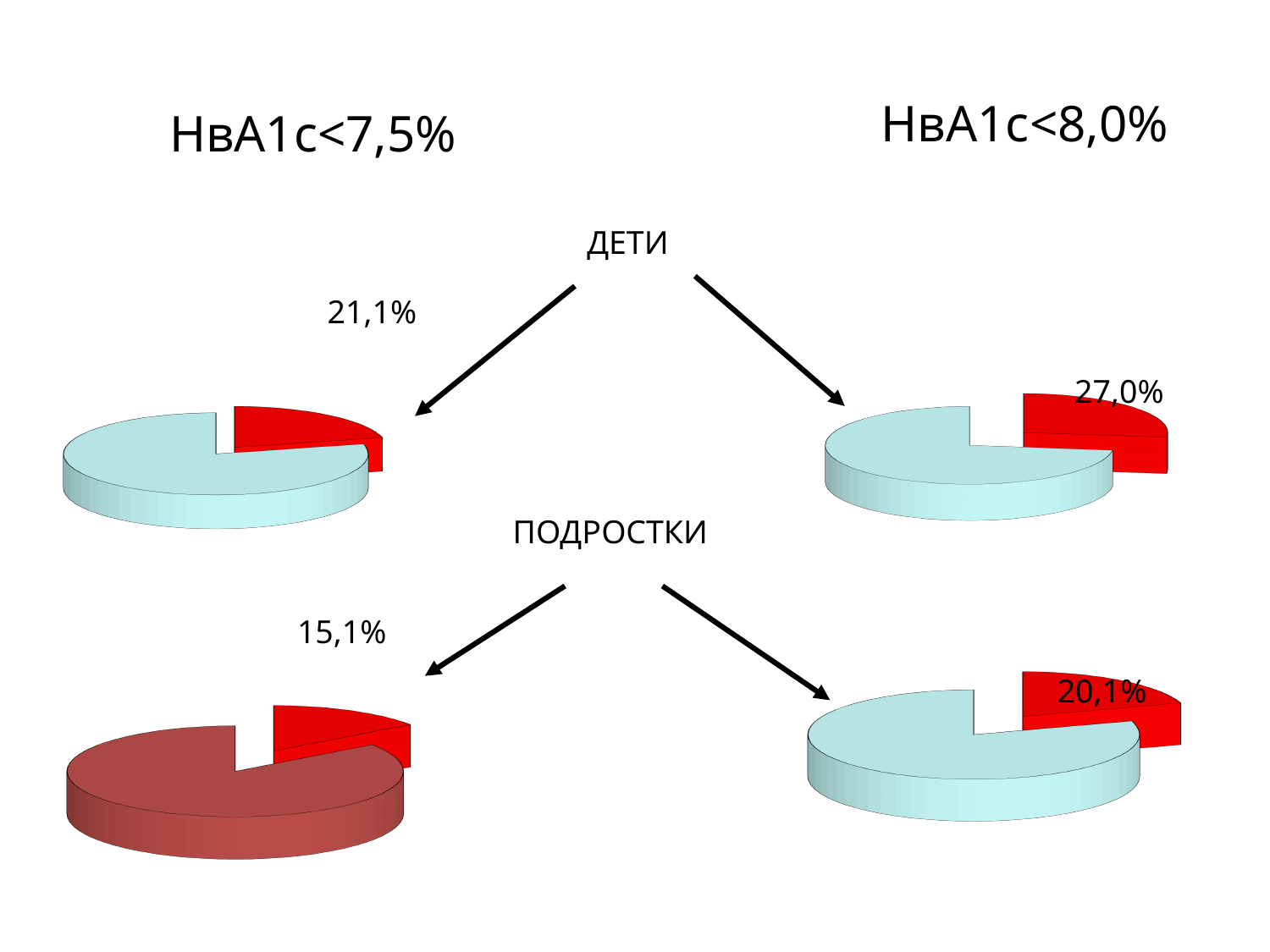
What type of chart is used on this slide? Pie chart What is the difference between the labelled percentages for ДЕТИ at HbA1c<8,0% and ДЕТИ at HbA1c<7,5%? 5,9% How many pie charts are shown on the slide? 4 In the top-right pie chart (ДЕТИ, HbA1c<8,0%), what percentage is shown for the red slice? 27,0% In the bottom-left pie chart (ПОДРОСТКИ, HbA1c<7,5%), what colour is the large non-exploded slice? Dark red What is the difference between the labelled percentages for ПОДРОСТКИ at HbA1c<8,0% and ПОДРОСТКИ at HbA1c<7,5%? 5,0% In the bottom-left pie chart (ПОДРОСТКИ, HbA1c<7,5%), what percentage is shown for the red slice? 15,1% Across the four pie charts, which group and threshold has the lowest labelled percentage? ПОДРОСТКИ, HbA1c<7,5% (15,1%) In the top-left pie chart (ДЕТИ, HbA1c<7,5%), what percentage is shown for the red slice? 21,1% Across the four pie charts, which group and threshold has the highest labelled percentage? ДЕТИ, HbA1c<8,0% (27,0%) Which is larger: the labelled percentage for ДЕТИ at HbA1c<7,5% or for ПОДРОСТКИ at HbA1c<7,5%? ДЕТИ at HbA1c<7,5% In the bottom-right pie chart (ПОДРОСТКИ, HbA1c<8,0%), what percentage is shown for the red slice? 20,1%